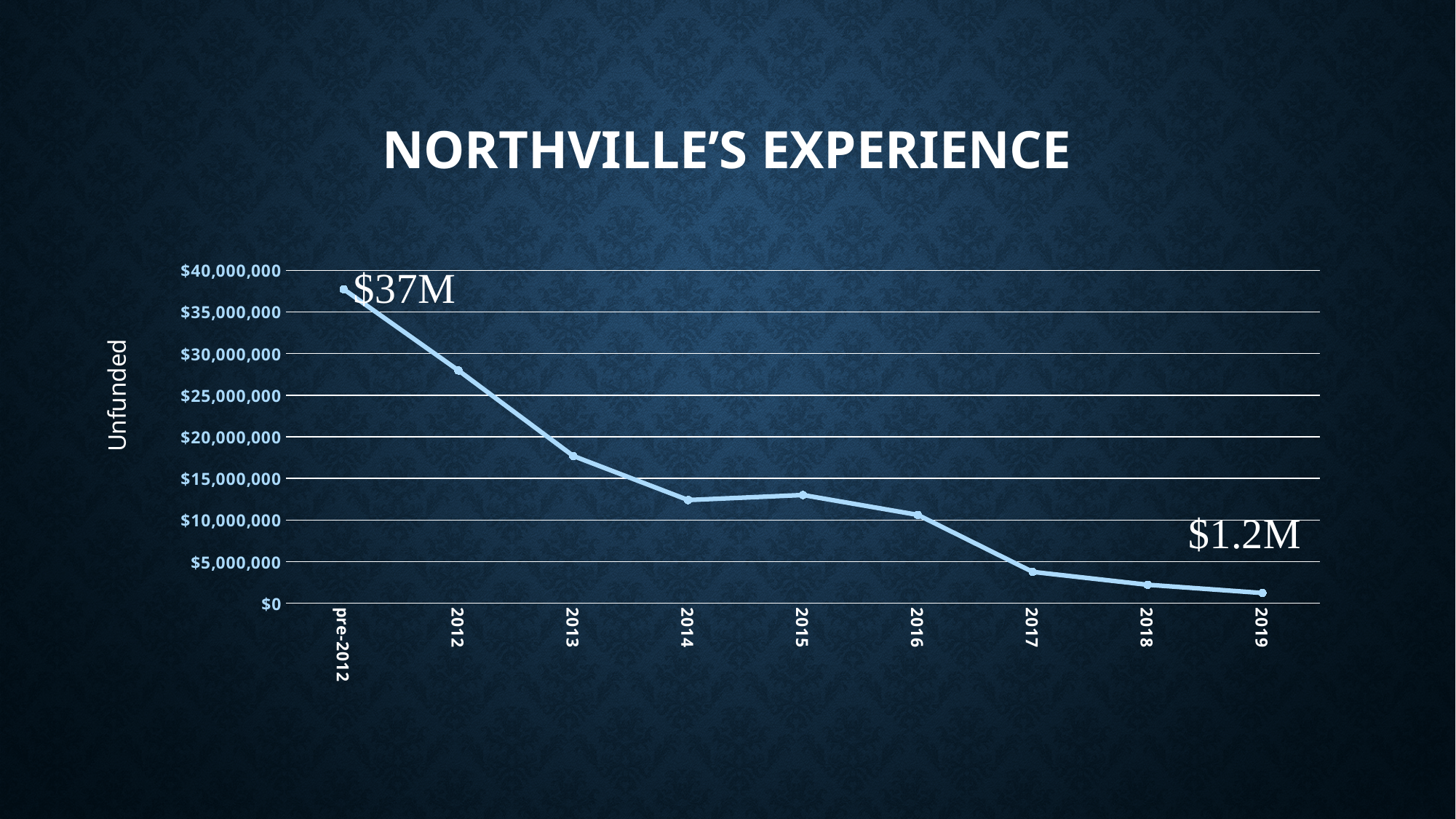
Which is larger, the value for 2012 or the value for 2016? 2012 Is the value for 2012 greater or less than $25,000,000? greater What unfunded value is labelled for 2019? $1.2M Is the value for 2013 greater or less than $20,000,000? less What is the label on the vertical axis? Unfunded What unfunded value is labelled for pre-2012? $37M What kind of chart is shown on the slide? line chart Which category has the highest unfunded value? pre-2012 Which category has the lowest unfunded value? 2019 Is the value for 2017 greater or less than $5,000,000? less How many points (categories) are plotted along the x axis? 9 Do the unfunded values rise or fall from pre-2012 to 2019? fall